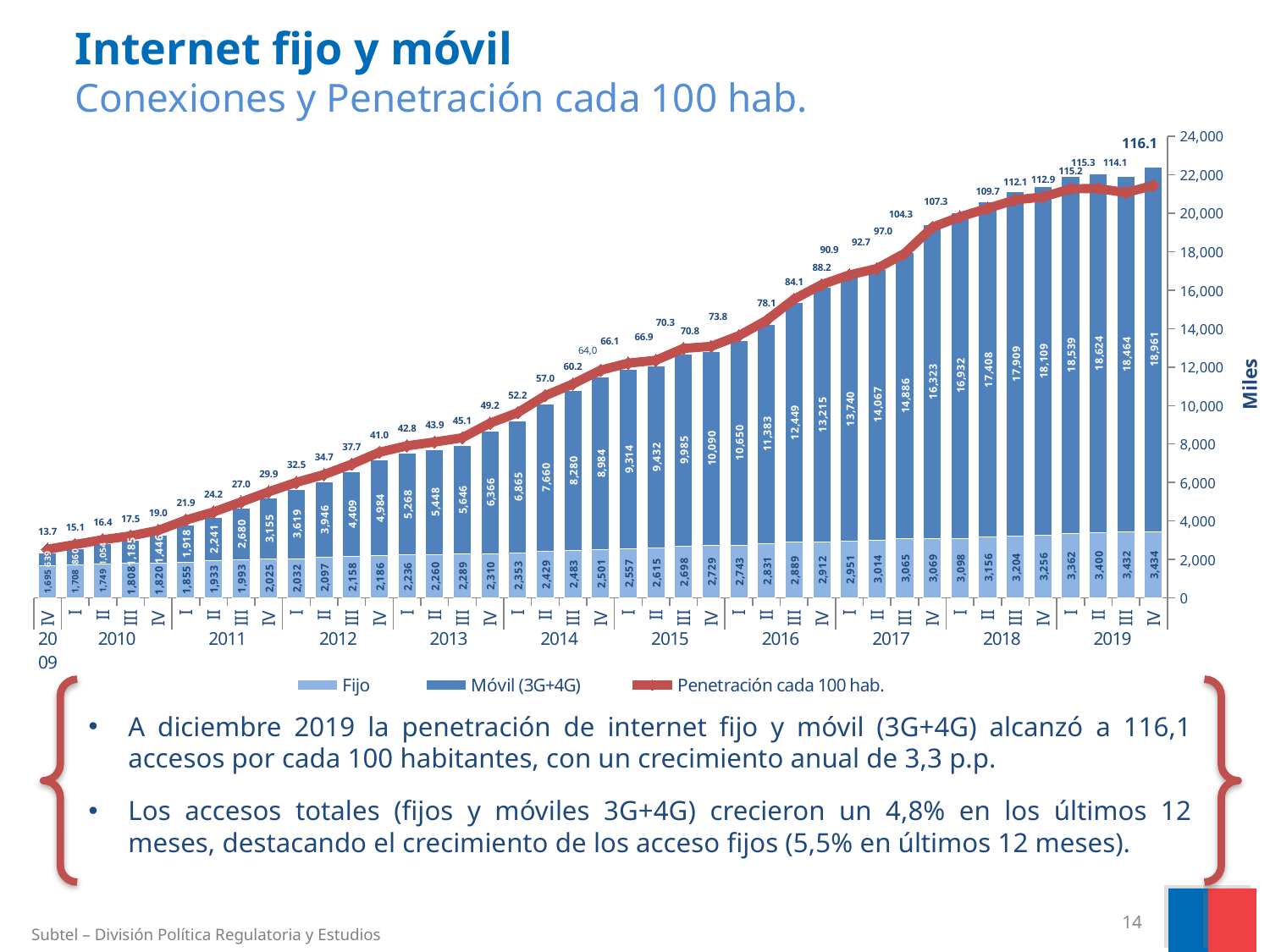
What kind of chart is shown on the slide? Stacked bar chart with a line What is the Fijo value for IV 2018? 3,256 What is the difference between the Móvil (3G+4G) values for IV 2019 and III 2019? 497 What is the Penetración cada 100 hab. value for IV 2019? 116.1 What is the total of the stacked bar (Fijo plus Móvil) for IV 2019? 22,395 In which quarter is the Penetración cada 100 hab. line highest? IV 2019 Does the Penetración cada 100 hab. line generally rise or fall from IV 2009 to IV 2019? rise In which quarter is the Fijo value lowest? IV 2009 Which is larger, the Móvil (3G+4G) value for II 2019 or for III 2019? II 2019 What is the Penetración cada 100 hab. value for IV 2009? 13.7 How many series does the legend list? 3 What is the Móvil (3G+4G) value for IV 2019? 18,961